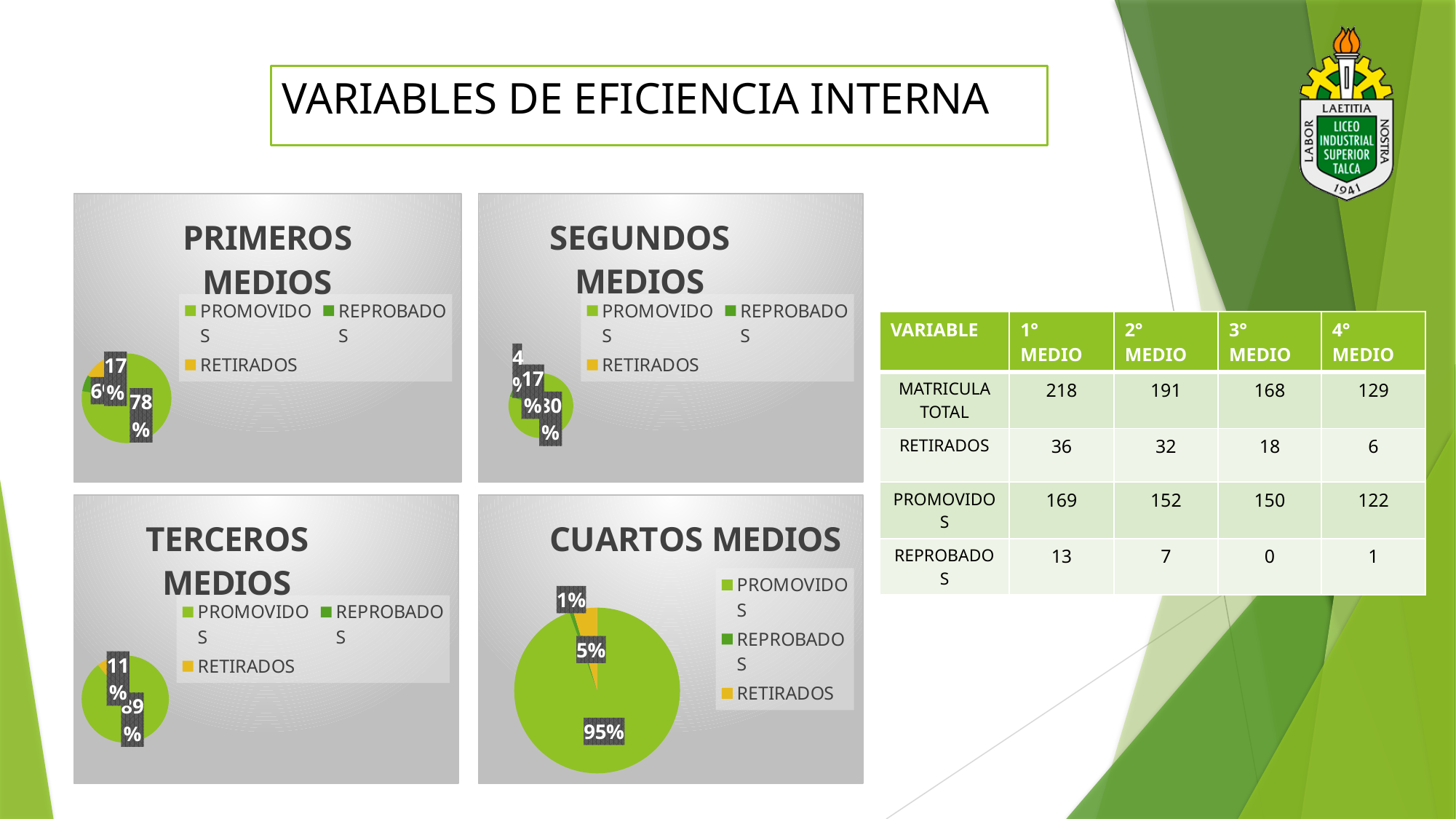
In the TERCEROS MEDIOS chart, what share of the pie is PROMOVIDOS? 89% In the CUARTOS MEDIOS chart, what is the difference between the PROMOVIDOS share and the RETIRADOS share? 90% In the PRIMEROS MEDIOS chart, which category has the largest slice? PROMOVIDOS In the CUARTOS MEDIOS chart, what share of the pie is PROMOVIDOS? 95% In the TERCEROS MEDIOS chart, what share of the pie is RETIRADOS? 11% In the CUARTOS MEDIOS chart, which category has the largest slice? PROMOVIDOS In the CUARTOS MEDIOS chart, which slice is larger, RETIRADOS or REPROBADOS? RETIRADOS How many entries does the legend of the CUARTOS MEDIOS chart list? 3 What kind of chart is the CUARTOS MEDIOS chart? pie chart